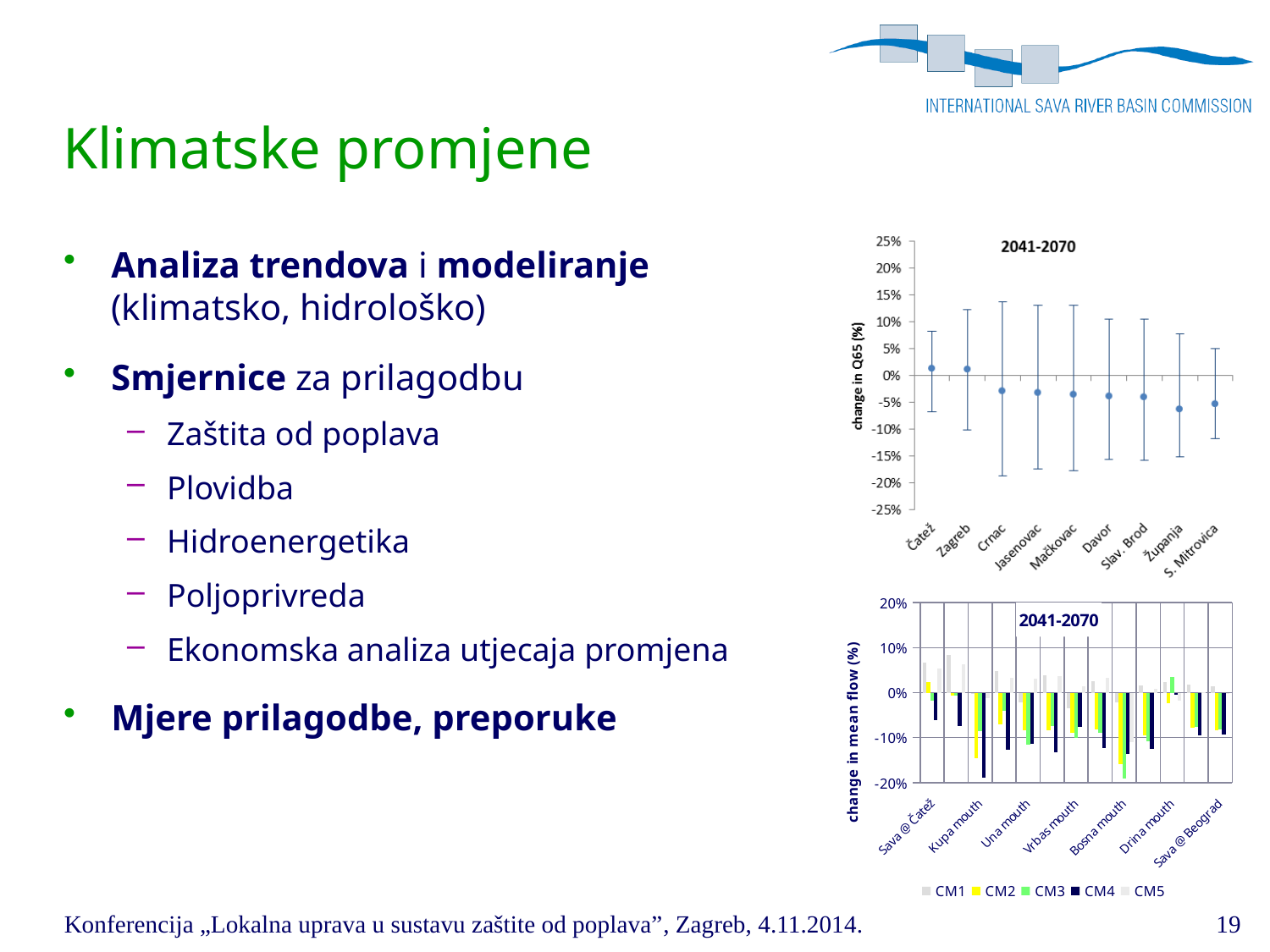
In the top chart (change in Q65), is the value for Županja greater or less than 0%? less How many stations are shown on the x axis of the top chart (change in Q65)? 9 In the top chart (change in Q65), is the value for Čatež greater or less than 0%? greater What kind of chart is the bottom chart titled 2041-2070 (change in mean flow)? bar chart What is the y-axis label of the top chart? change in Q65 [%] In the bottom chart (change in mean flow), is the CM4 value at Kupa mouth greater or less than -10%? less What period is shown in the title of both charts? 2041-2070 How many series does the legend of the bottom chart (change in mean flow) list? 5